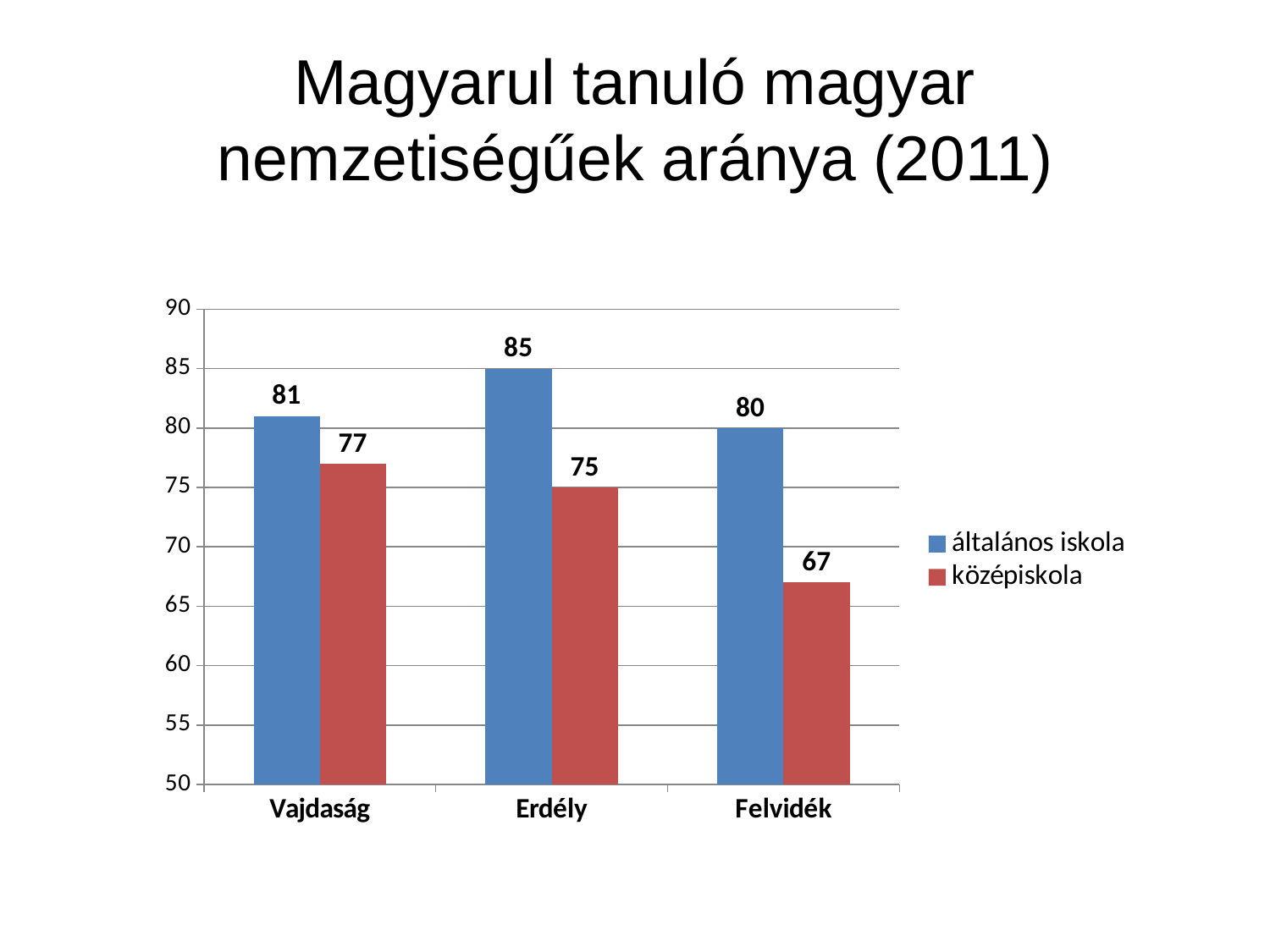
Which region has the highest value for általános iskola? Erdély What is the difference between the általános iskola and középiskola values in Felvidék? 13 How many regions are shown on the x axis? 3 What is the value for középiskola in Vajdaság? 77 Is the value for általános iskola in Felvidék greater or less than 75? greater How many series does the legend list? 2 Which is larger: the középiskola value for Vajdaság or for Erdély? Vajdaság What is the value for középiskola in Felvidék? 67 What kind of chart is shown on the slide? bar chart What is the value for általános iskola in Erdély? 85 Which region has the lowest value for középiskola? Felvidék Which colour represents középiskola in the chart? red